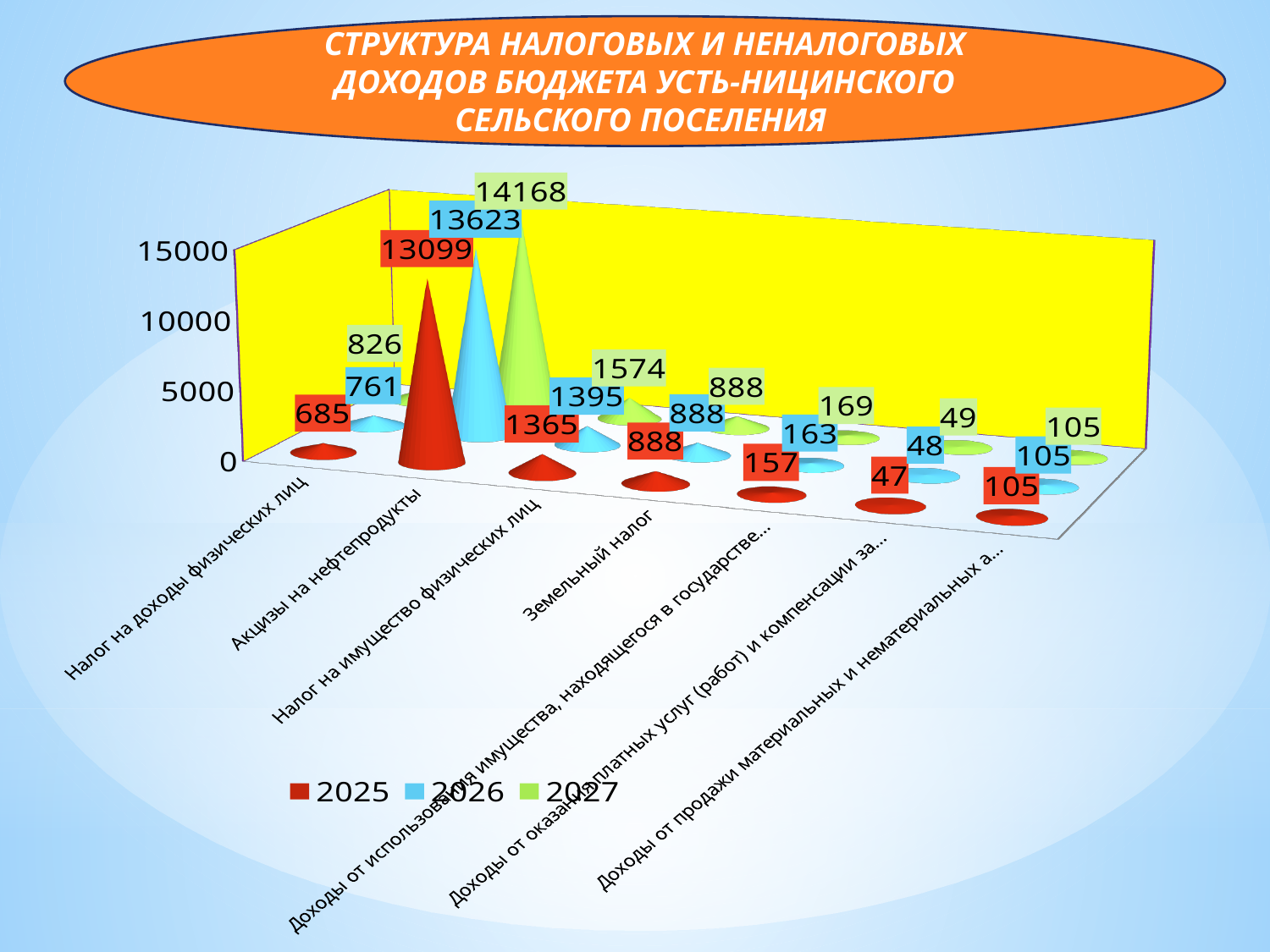
What is the value for Акцизы на нефтепродукты in the 2027 series? 14168 What is the value for Земельный налог in the 2027 series? 888 Which colour represents the 2026 series in the legend? blue What is the value for Налог на имущество физических лиц in the 2026 series? 1395 Which category has the lowest value in the 2026 series? Доходы от оказания платных услуг (работ) и компенсации за... What is the value for Налог на доходы физических лиц in the 2025 series? 685 How many series does the legend list? 3 How many categories are shown on the x axis? 7 What is the difference between the 2027 and 2025 values for Акцизы на нефтепродукты? 1069 Which is larger for Налог на имущество физических лиц: the 2025 value or the 2027 value? 2027 Do the values for Налог на доходы физических лиц rise or fall from 2025 to 2027? rise Which category has the highest value in the 2025 series? Акцизы на нефтепродукты